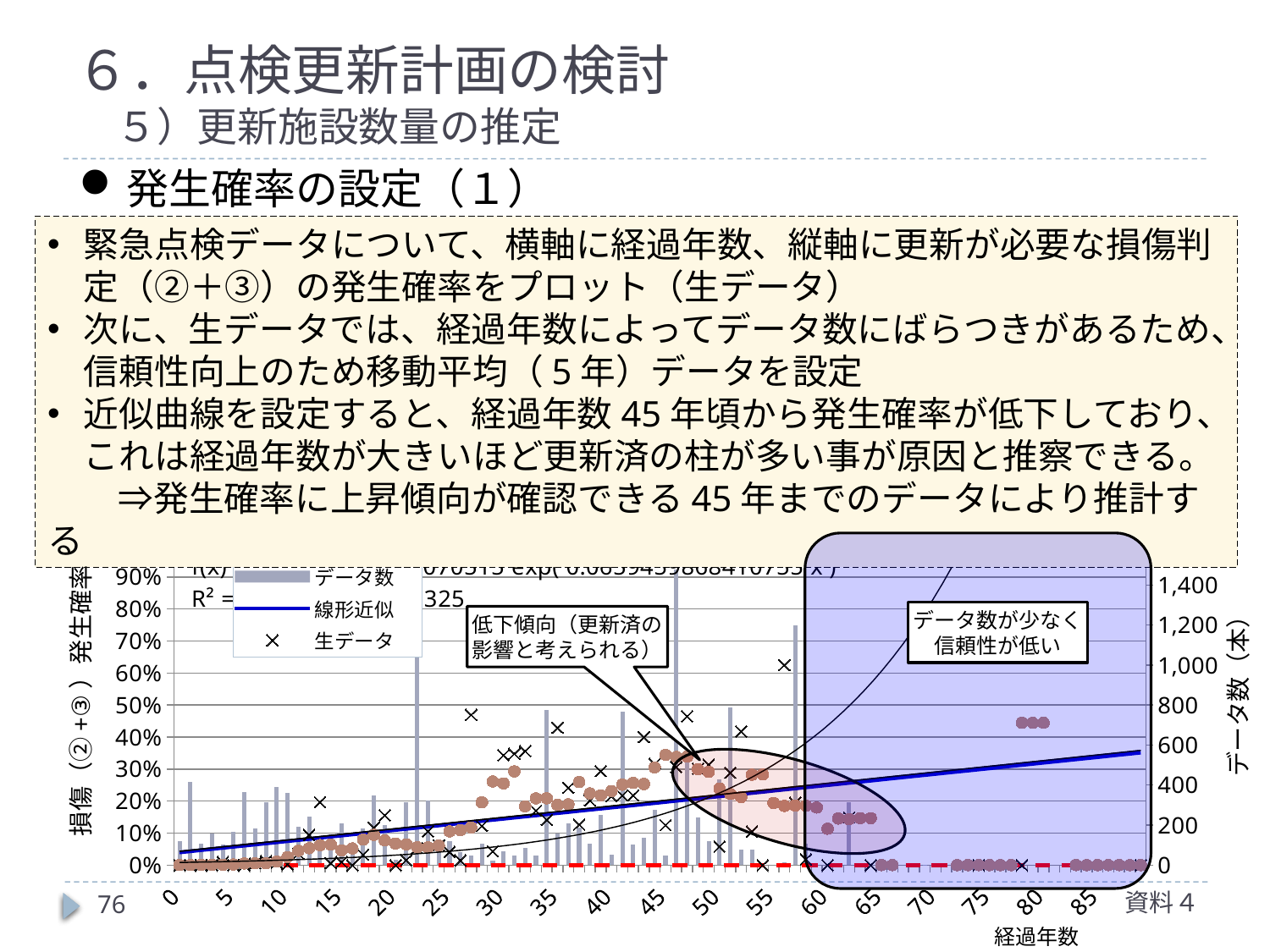
Which series does the legend show with a blue line? 線形近似 What kind of chart is shown on the slide? A combination chart with bars, a line and scatter points Is the value of the 線形近似 line at 経過年数 0 greater or less than 10%? less What is the title of the x axis of the chart? 経過年数 Is the value of the 線形近似 line at 経過年数 85 greater or less than 30%? greater How many tick labels are shown on the x axis (経過年数)? 18 Is the tallest データ数 bar, near 経過年数 47, greater or less than 1,000 on the right axis? greater Does the 線形近似 line rise or fall as 経過年数 increases? rises